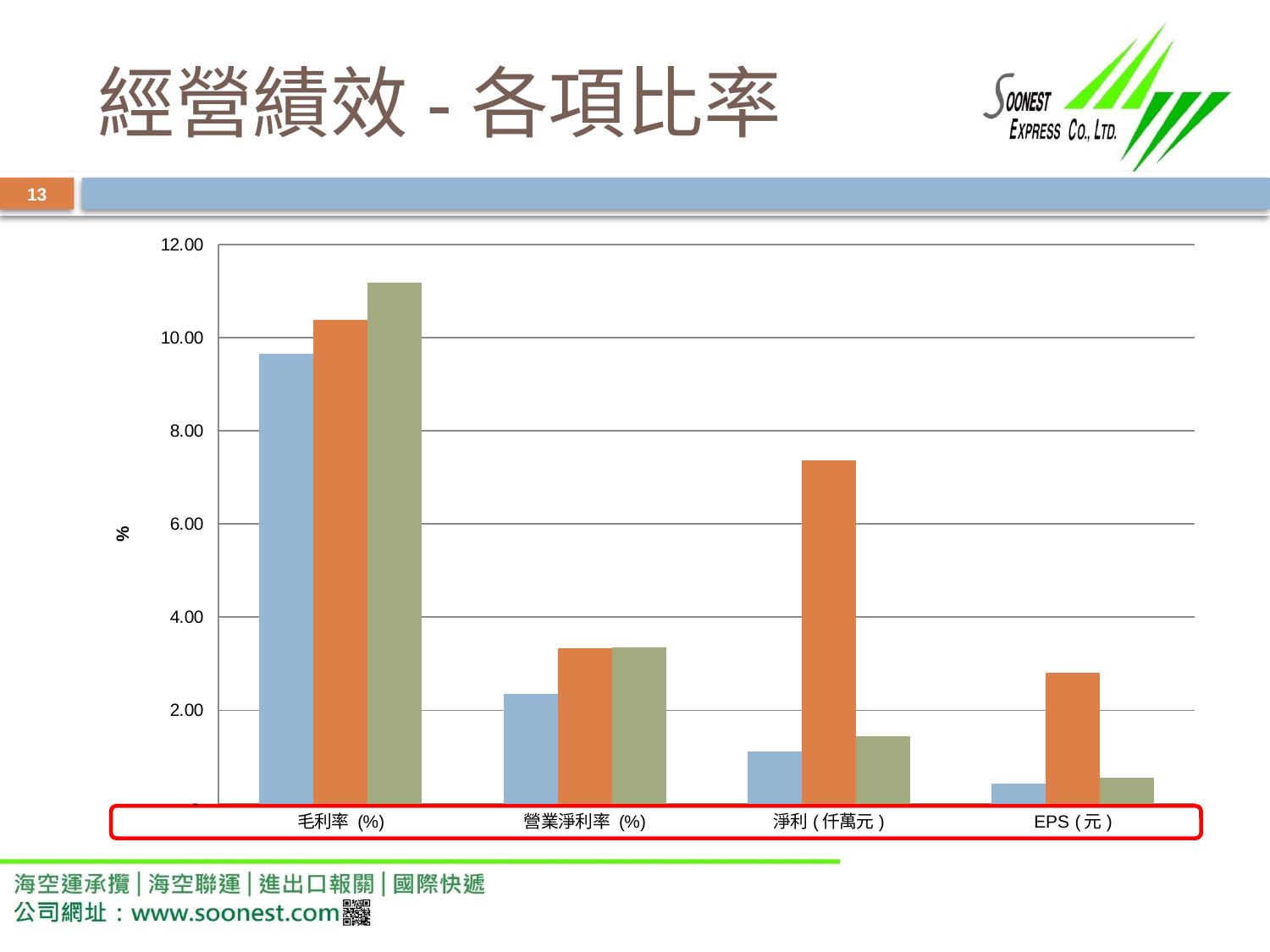
Which category contains the shortest bar in the chart? EPS (元) What kind of chart is shown on the slide? bar chart Is the value of the green bar for 淨利 (仟萬元) greater or less than 2.00? less Is the value of the blue bar for 毛利率 (%) greater or less than 8.00? greater Is the value of the orange bar for 淨利 (仟萬元) greater or less than 8.00? less For 淨利 (仟萬元), which is larger: the blue bar or the orange bar? orange bar What is the title of the slide containing the chart? 經營績效 - 各項比率 How many bars are plotted for each category in the chart? 3 Which category has the tallest bars in the chart? 毛利率 (%) How many categories are shown on the x axis of the chart? 4 Within the 淨利 (仟萬元) category, which coloured bar is the tallest? orange